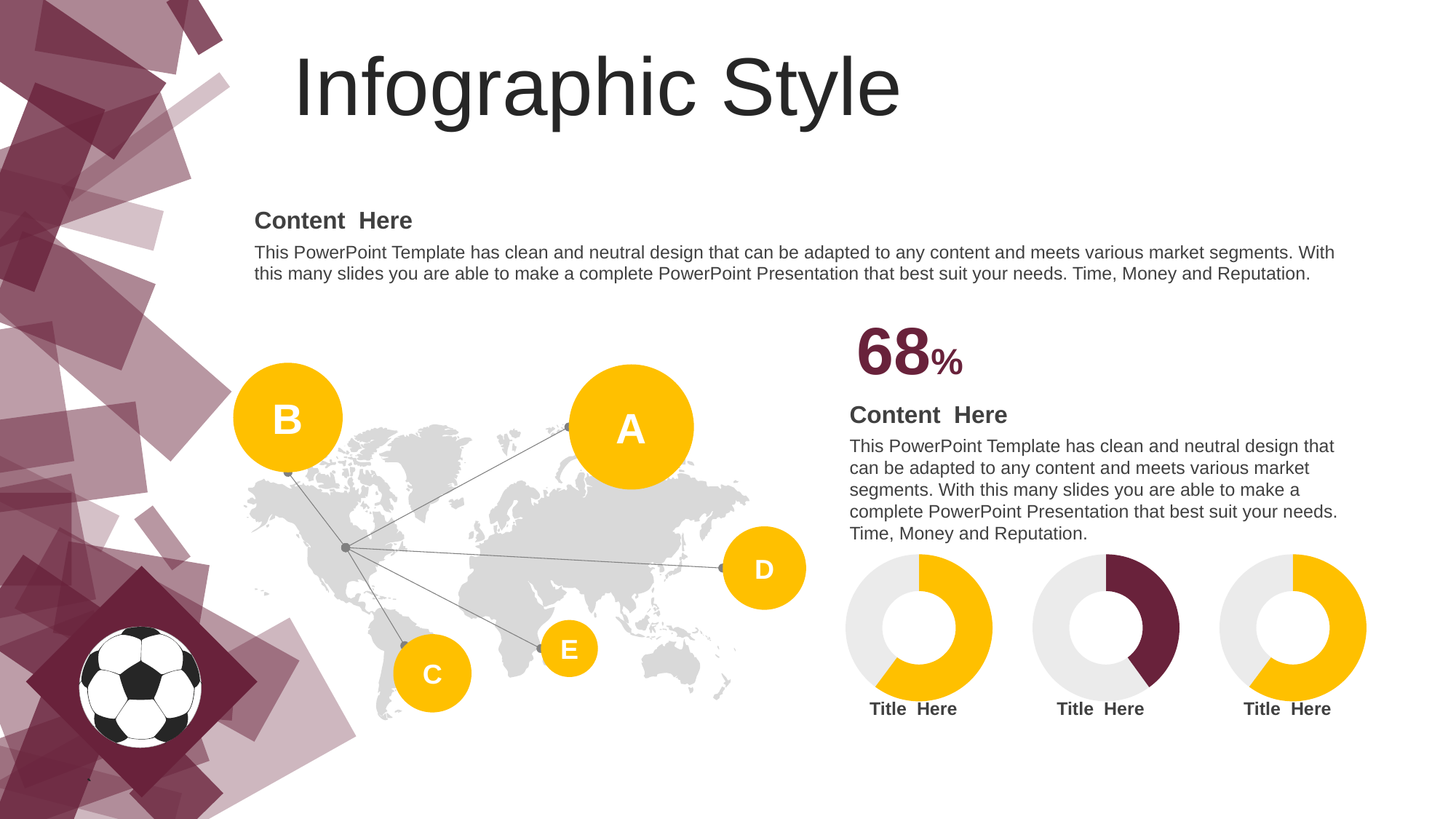
Of the three donut charts, which one has the smallest filled portion? The middle one What label appears beneath each of the three donut charts? Title Here What colour is the filled portion of the left and right donut charts? Yellow What kind of chart are the three charts at the bottom right of the slide? Donut chart How many donut charts are shown on the slide? 3 What colour is the filled portion of the middle donut chart? Dark maroon Is the filled portion of the left donut chart larger or smaller than that of the middle donut chart? Larger Is the filled portion of the right donut chart larger or smaller than that of the middle donut chart? Larger